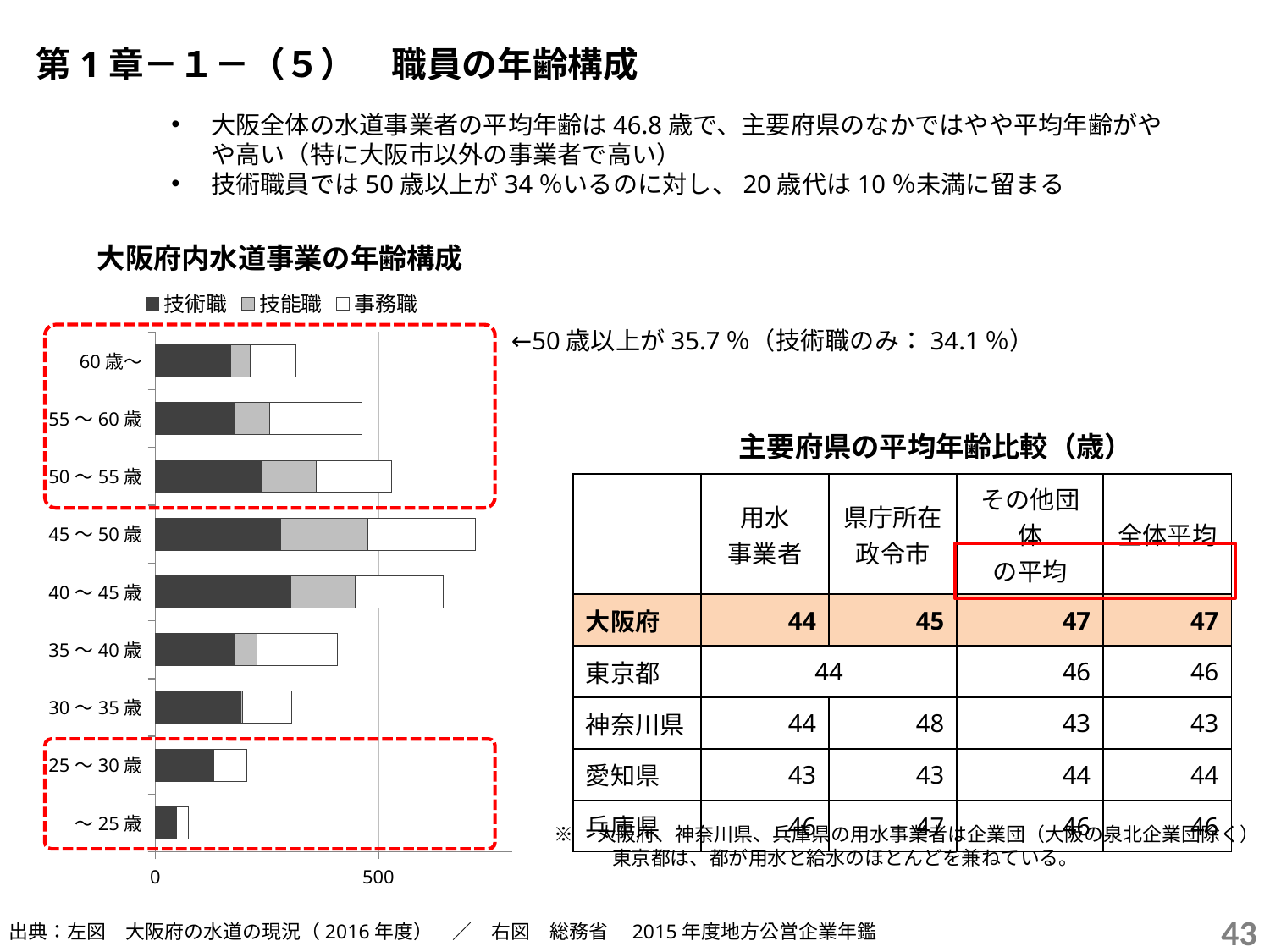
In the 大阪府内水道事業の年齢構成 chart, is the total bar for 40～45歳 greater or less than 500? greater How many age categories are plotted in the 大阪府内水道事業の年齢構成 chart? 9 In the 大阪府内水道事業の年齢構成 chart, is the total bar for 45～50歳 greater or less than 500? greater In the 大阪府内水道事業の年齢構成 chart, is the total bar for 35～40歳 greater or less than 500? less In the 大阪府内水道事業の年齢構成 chart, which age category has the longest total bar? 45～50歳 What kind of chart is shown under the title 大阪府内水道事業の年齢構成? Stacked horizontal bar chart In the 大阪府内水道事業の年齢構成 chart, which total bar is longer: 30～35歳 or 25～30歳? 30～35歳 In the 大阪府内水道事業の年齢構成 chart, which age category has the shortest total bar? ～25歳 What are the three series named in the legend of the 大阪府内水道事業の年齢構成 chart? 技術職, 技能職, 事務職 How many series does the legend of the 大阪府内水道事業の年齢構成 chart list? 3 What is the title of the bar chart on the left of the slide? 大阪府内水道事業の年齢構成 In the 大阪府内水道事業の年齢構成 chart, which 技術職 segment is longer: 60歳～ or ～25歳? 60歳～